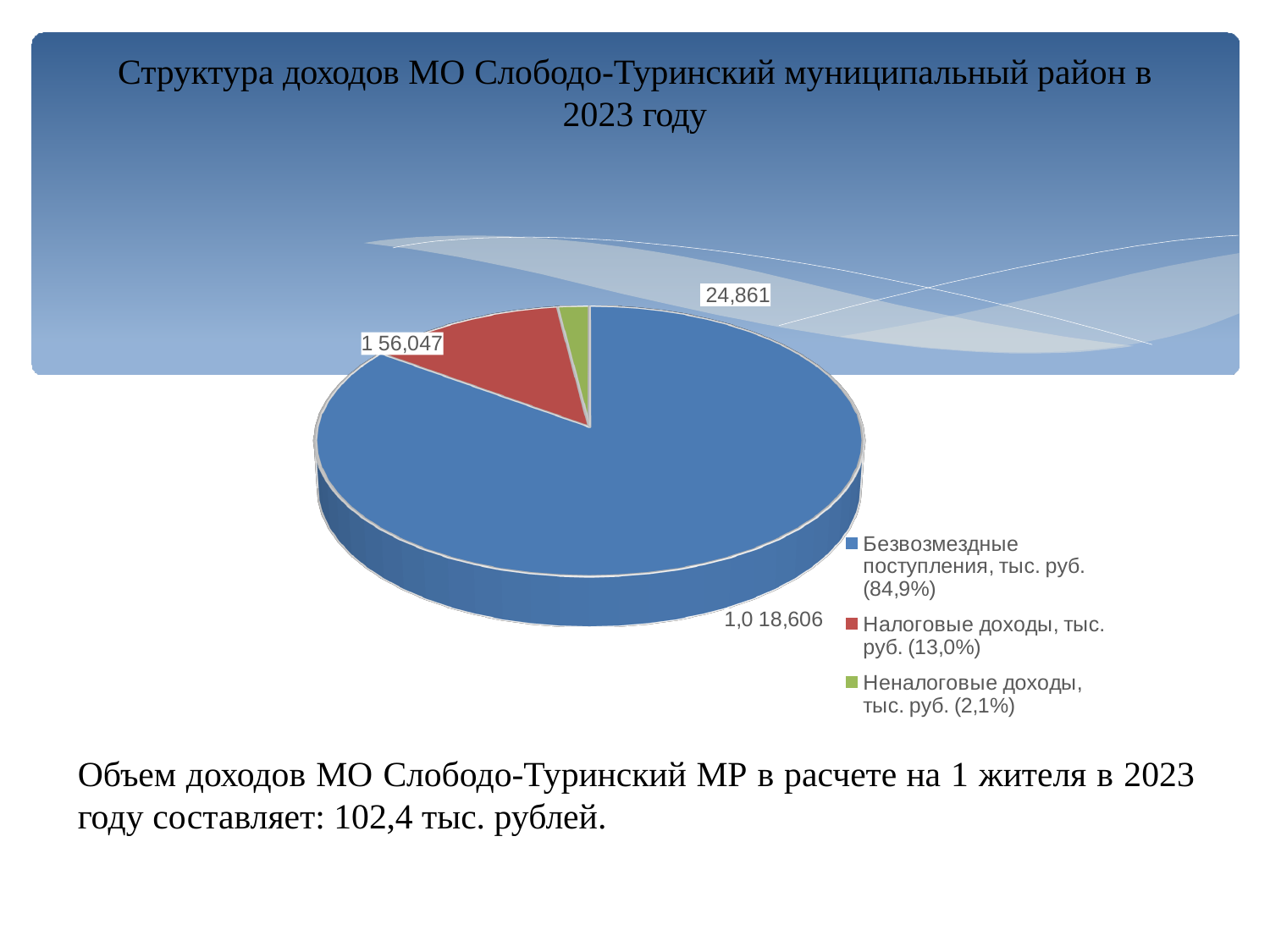
What colour is the "Налоговые доходы" slice? Red Which slice is larger: "Налоговые доходы" or "Неналоговые доходы"? Налоговые доходы What kind of chart is shown on the slide? Pie chart What share of the pie does "Неналоговые доходы" account for, according to the legend? 2,1% By how many percentage points does the share of "Безвозмездные поступления" exceed the share of "Налоговые доходы"? 71,9 What share of the pie does "Налоговые доходы" account for, according to the legend? 13,0% What is the title of the chart? Структура доходов МО Слободо-Туринский муниципальный район в 2023 году How many slices does the pie chart have? 3 What share of the pie does "Безвозмездные поступления" account for, according to the legend? 84,9% Which category has the smallest slice of the pie? Неналоговые доходы What data label is shown on the "Неналоговые доходы" slice? 24,861 Which category has the largest slice of the pie? Безвозмездные поступления